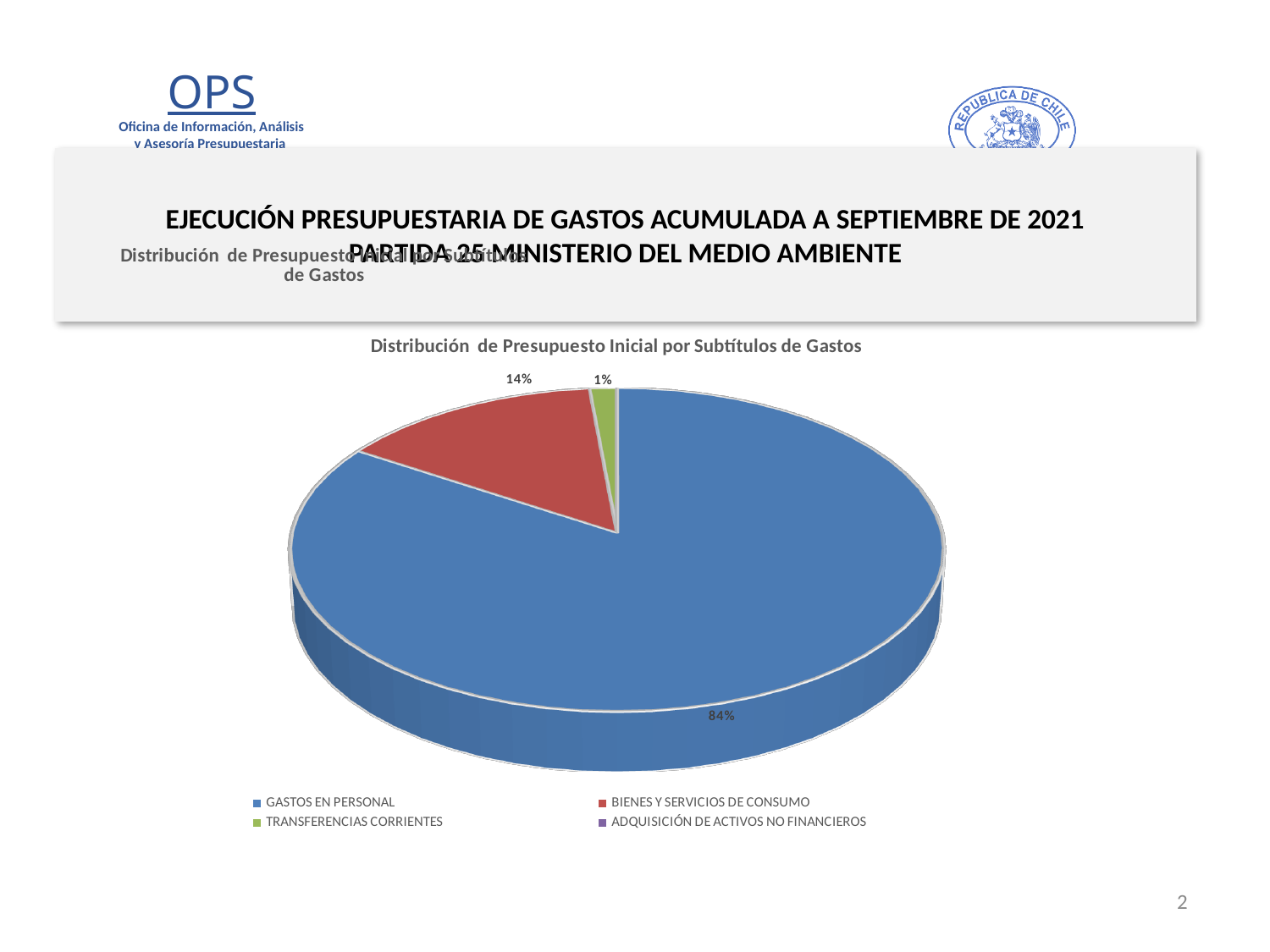
How many slices have a percentage label printed on the pie? 3 How many entries does the legend list? 4 What share of the pie does BIENES Y SERVICIOS DE CONSUMO represent? 14% Which is larger, the BIENES Y SERVICIOS DE CONSUMO slice or the TRANSFERENCIAS CORRIENTES slice? BIENES Y SERVICIOS DE CONSUMO Which category has the largest slice of the pie? GASTOS EN PERSONAL Which of the labeled slices is the smallest? TRANSFERENCIAS CORRIENTES What is the title of the chart? Distribución de Presupuesto Inicial por Subtítulos de Gastos What share of the pie does GASTOS EN PERSONAL represent? 84% What is the difference in percentage points between the GASTOS EN PERSONAL slice and the BIENES Y SERVICIOS DE CONSUMO slice? 70 percentage points What share of the pie does TRANSFERENCIAS CORRIENTES represent? 1% What kind of chart is shown on the slide? Pie chart What colour is the GASTOS EN PERSONAL slice? Blue